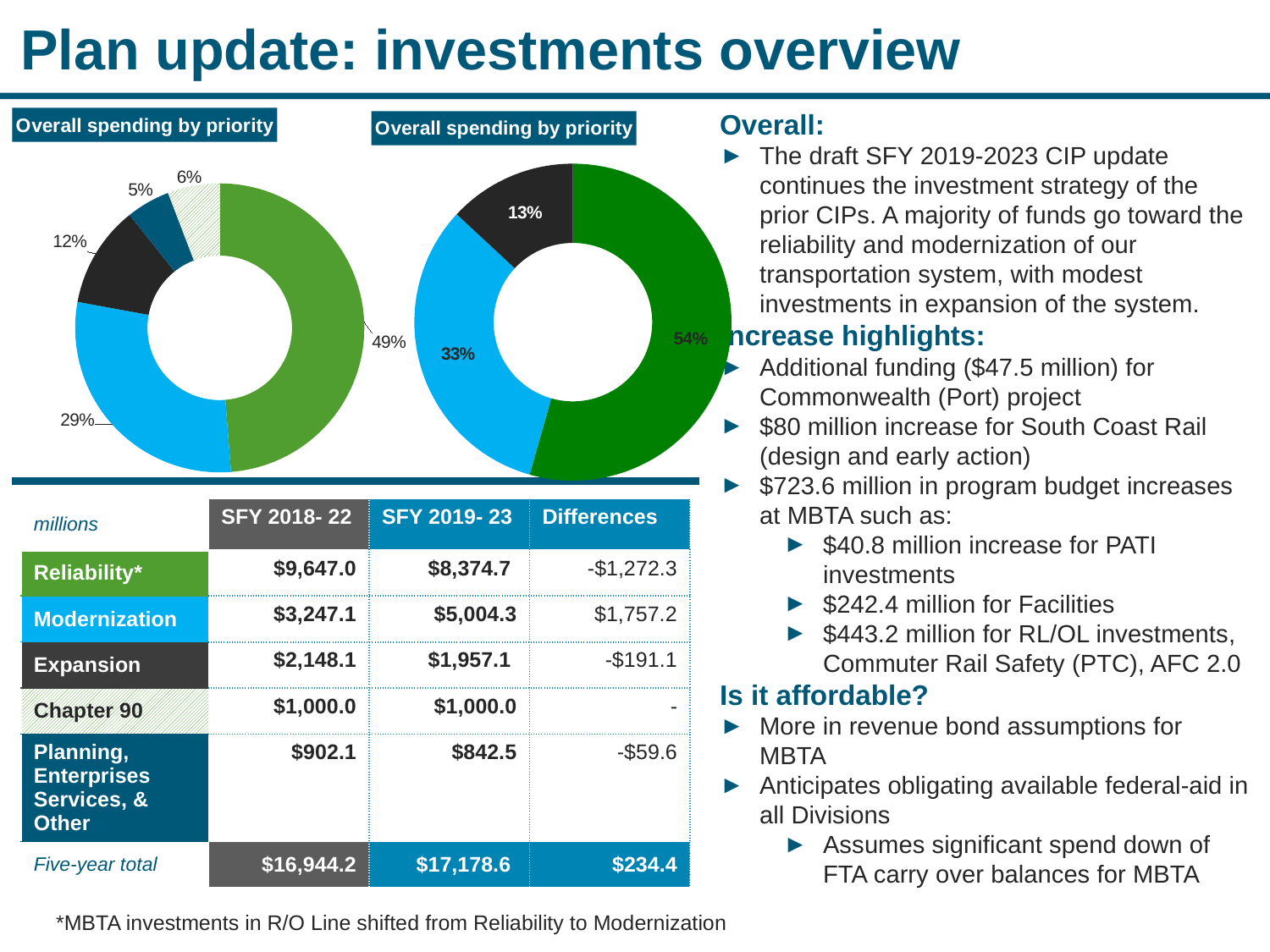
In the right donut chart, what is the value of the smallest slice? 13% What kind of chart is used for the two 'Overall spending by priority' visuals? Donut (pie) chart What title is shown above each of the two donut charts? Overall spending by priority In the right donut chart, what is the value of the light blue slice? 33% In the right donut chart, what is the difference between the largest slice (54%) and the light blue slice (33%)? 21 percentage points In the left donut chart, what is the value of the largest slice? 49% In the right donut chart, what is the value of the largest slice? 54% In the left donut chart, what is the value of the hatched (striped) slice? 6% How many slices does the right donut chart have? 3 How many slices does the left donut chart have? 5 In the left donut chart, which is larger: the light blue slice or the dark gray slice? The light blue slice (29%) In the left donut chart, what is the value of the smallest slice? 5%